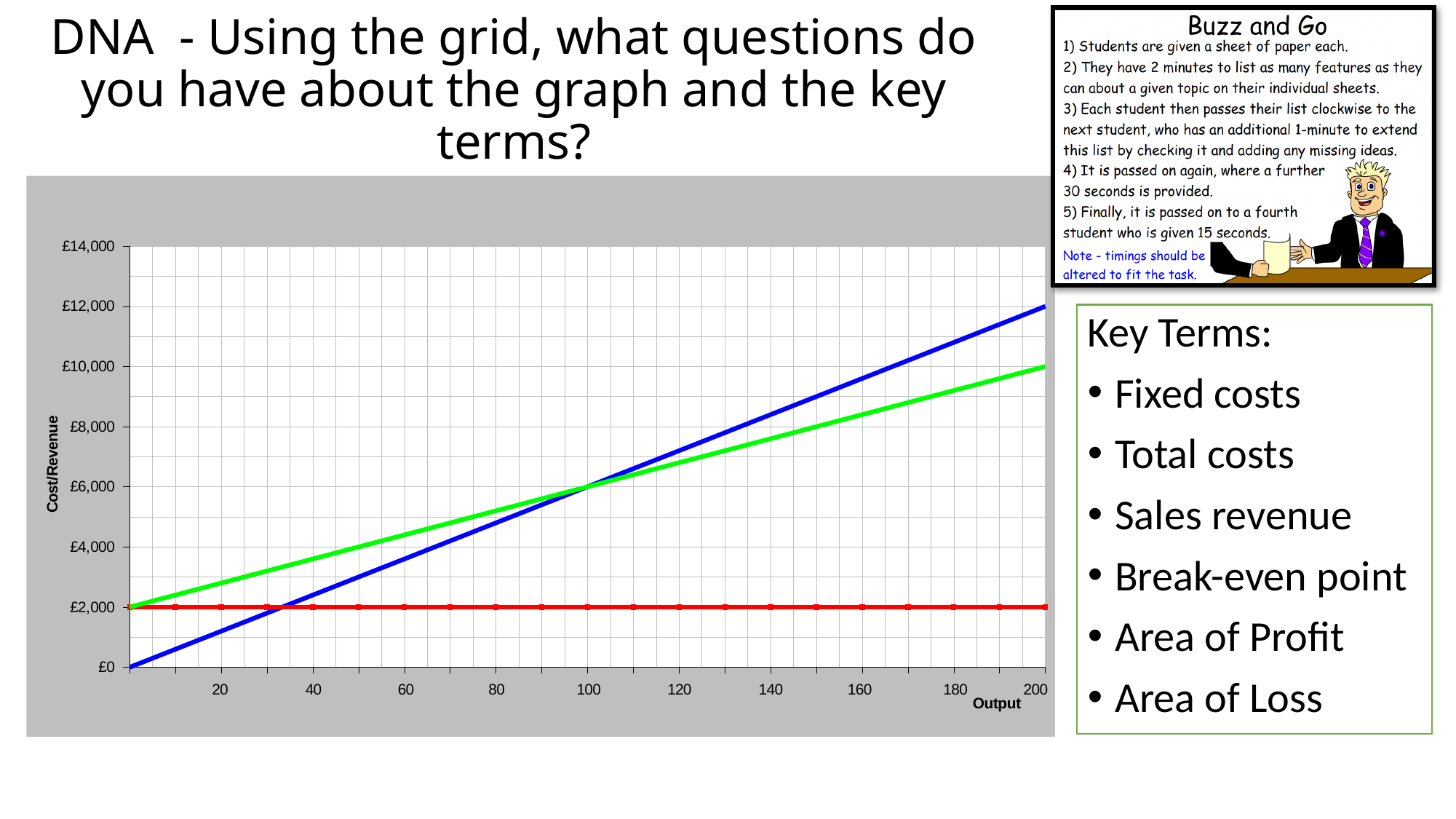
What is the value of the green line at an output of 200? £10,000 What is the label of the vertical axis of the chart? Cost/Revenue What is the difference between the blue line and the green line at an output of 200? £2,000 What is the value of the blue line at an output of 200? £12,000 What kind of chart is shown on the slide? Line chart At an output of 160, is the blue line greater or less than £8,000? greater At what output level do the blue and green lines cross? 100 What is the label of the horizontal axis of the chart? Output How many lines are plotted on the chart? 3 Does the blue line rise or fall as output increases? Rises What value does the red line stay at across all output levels? £2,000 What is the value of the blue line at an output of 0? £0